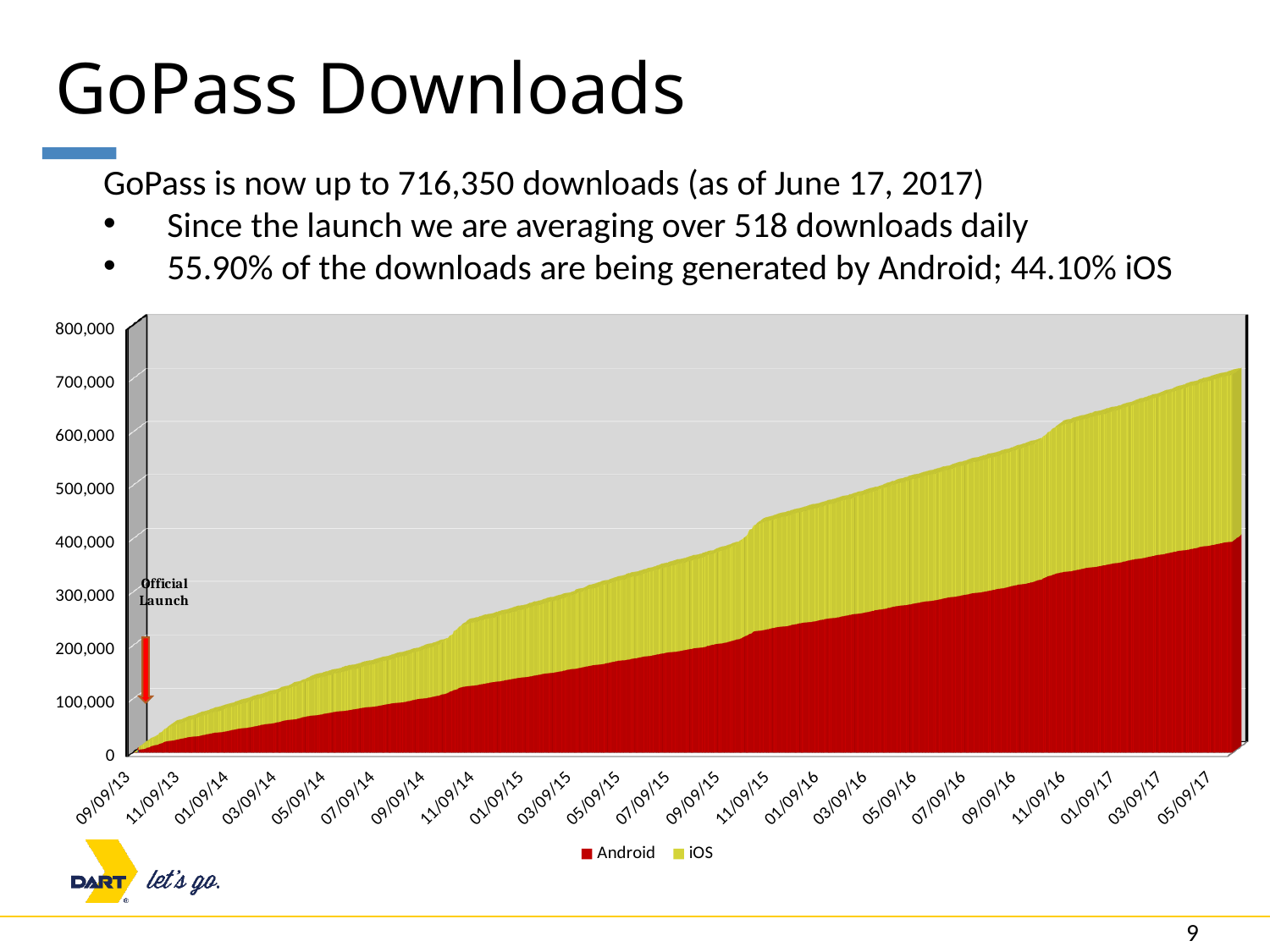
Is the total stacked value at 01/09/15 greater or less than 200,000? greater Is the total stacked value at 05/09/17 greater or less than 600,000? greater What kind of chart is shown on the slide? Stacked area chart How many series does the chart legend list? 2 At 05/09/17, which series has the larger value, Android or iOS? Android Which colour represents Android in the chart? Red Is the Android value at 01/09/16 greater or less than 200,000? greater What is the first date label shown on the x axis? 09/09/13 Do the cumulative download values rise or fall along the x axis? Rise Which two series are listed in the chart legend? Android and iOS